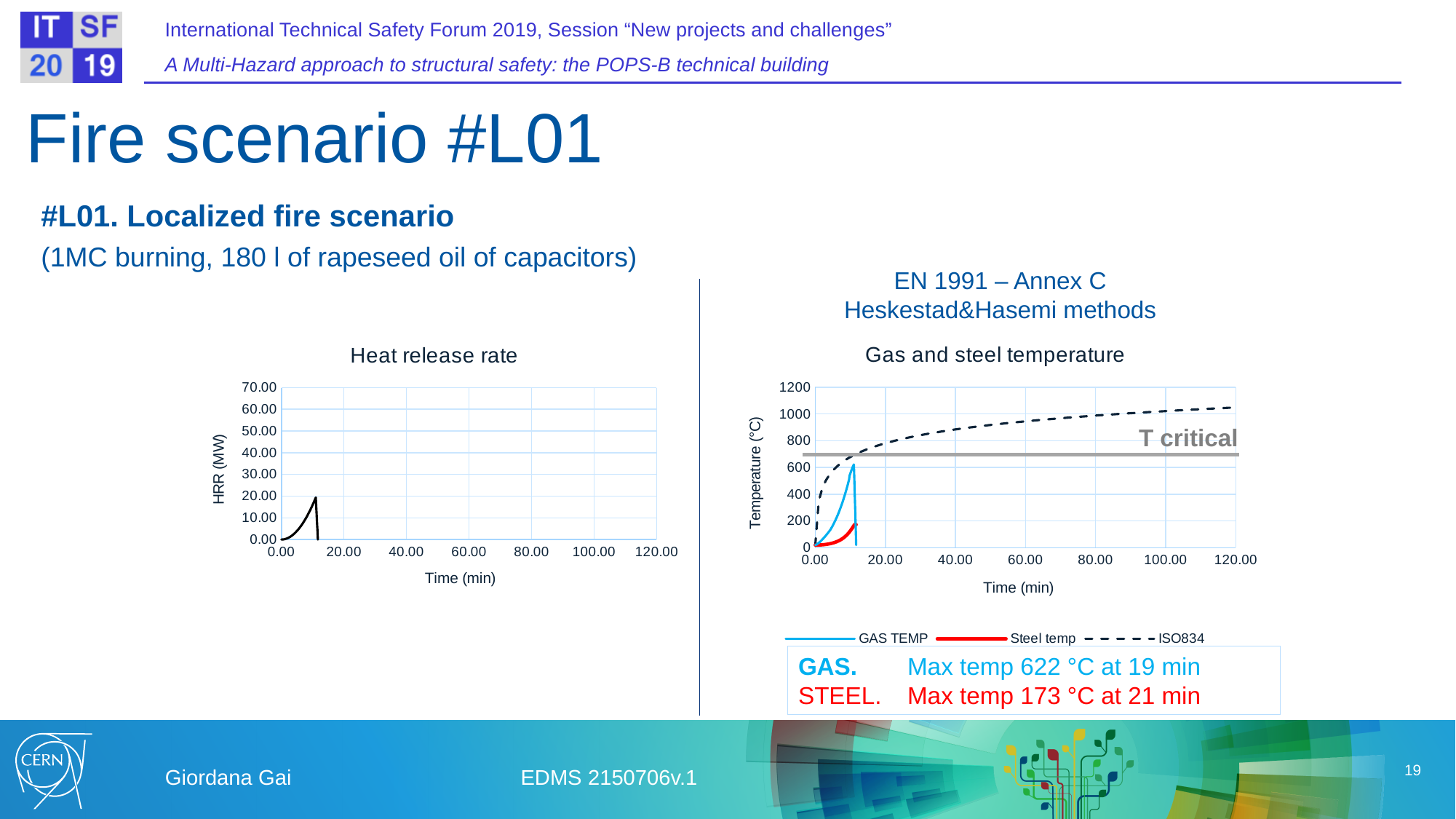
In the "Gas and steel temperature" chart, does the ISO834 curve rise or fall along the time axis? rise In the "Gas and steel temperature" chart, at what time does the steel temperature reach its maximum? 21 min In the "Gas and steel temperature" chart, what is the maximum steel temperature reached? 173 °C What kind of chart is the "Heat release rate" chart? line chart In the "Gas and steel temperature" chart, what is the difference between the maximum gas temperature and the maximum steel temperature? 449 °C In the "Gas and steel temperature" chart, which series is drawn as a dashed line? ISO834 In the "Gas and steel temperature" chart, is the ISO834 value at 120.00 min greater or less than 1000? greater In the "Gas and steel temperature" chart, at what time does the gas temperature reach its maximum? 19 min In the "Gas and steel temperature" chart, which reaches a higher maximum temperature, the gas or the steel? gas In the "Gas and steel temperature" chart, what is the maximum gas temperature reached? 622 °C How many series does the legend of the "Gas and steel temperature" chart list? 3 In the "Heat release rate" chart, is the peak HRR value greater or less than 30.00? less